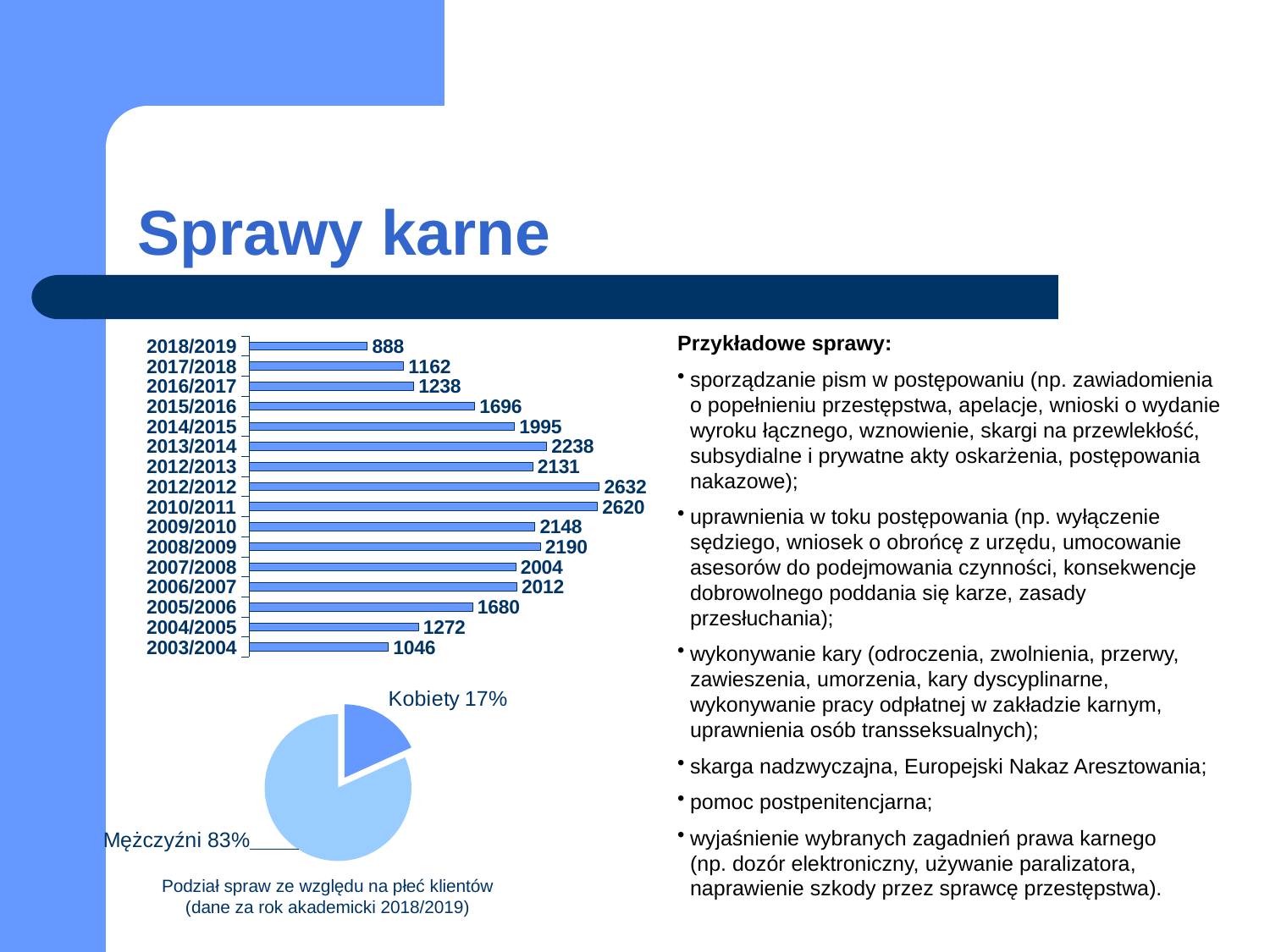
On the bar chart, which is larger: the value for 2015/2016 or the value for 2005/2006? 2015/2016 On the bar chart, what is the value for 2010/2011? 2620 On the bar chart, what is the value for 2003/2004? 1046 How many categories does the bar chart show? 16 On the pie chart, what share is labelled for Mężczyźni? 83% On the pie chart, what share is labelled for Kobiety? 17% On the bar chart, what is the value for 2018/2019? 888 What kind of chart is the chart at the bottom left of the slide? pie chart On the bar chart, what is the difference between the values for 2013/2014 and 2012/2013? 107 On the bar chart, which category has the lowest value? 2018/2019 On the bar chart, which category has the highest value? 2012/2012 What kind of chart is the chart at the top left of the slide? bar chart